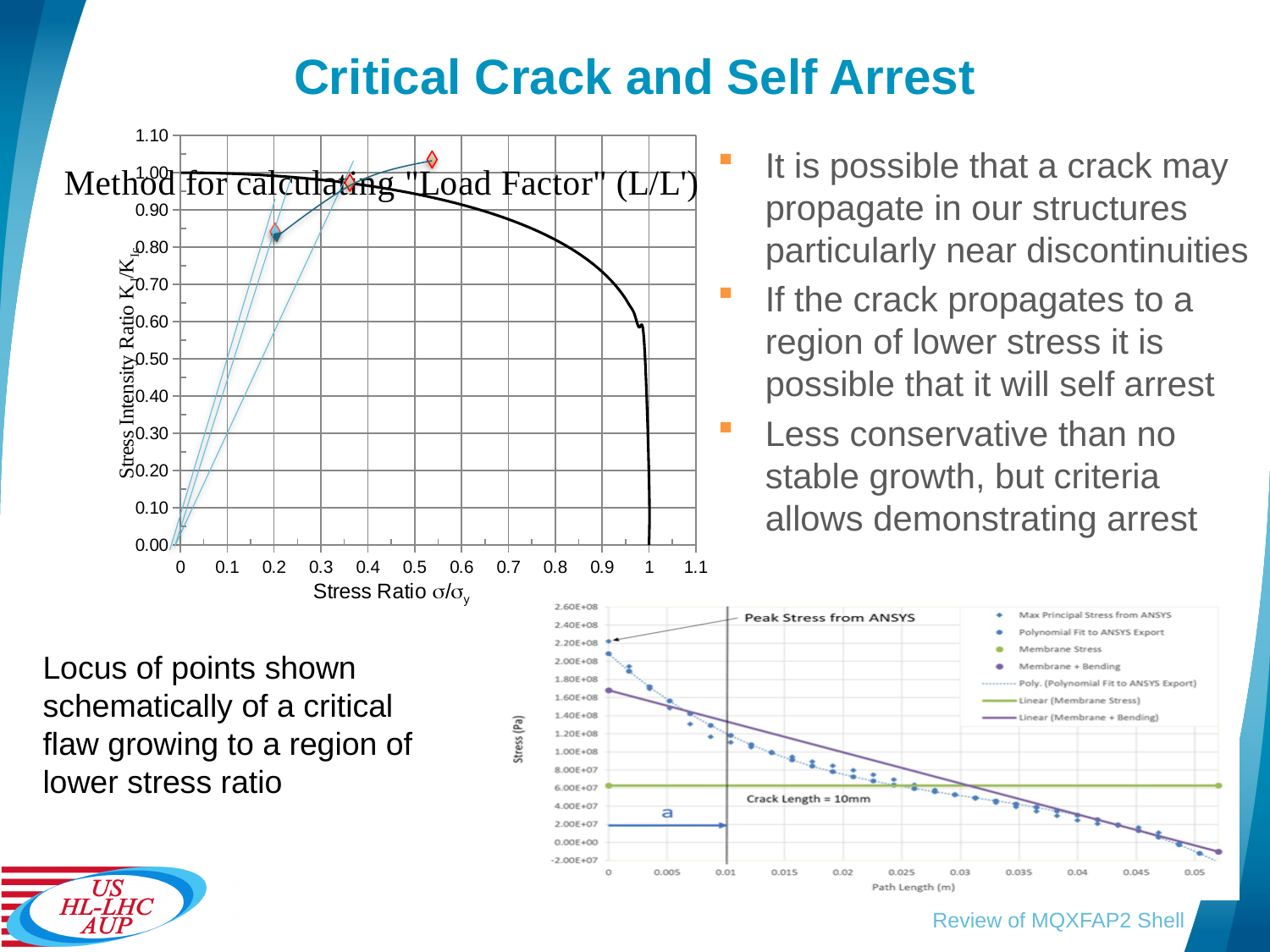
In the bottom-right chart, is the Max Principal Stress from ANSYS at a path length of 0 greater or less than 2.00E+08? greater In the top-left chart, what is the label of the x axis? Stress Ratio σ/σy In the bottom-right chart, how many entries does the legend list? 7 In the bottom-right chart, is the Membrane + Bending value at a path length of 0 greater or less than 2.00E+08? less In the bottom-right chart, what is the label of the x axis? Path Length (m) In the bottom-right chart, does the Max Principal Stress from ANSYS rise or fall as path length increases? fall What type of chart is the top-left chart titled "Method for calculating "Load Factor" (L/L')"? line chart In the top-left chart, what is the label of the y axis? Stress Intensity Ratio KI/KIc In the top-left chart, is the value of the black curve at a stress ratio of 0.9 greater or less than 0.80? less In the top-left chart, does the black curve rise or fall as the stress ratio increases from 0 to 1? fall